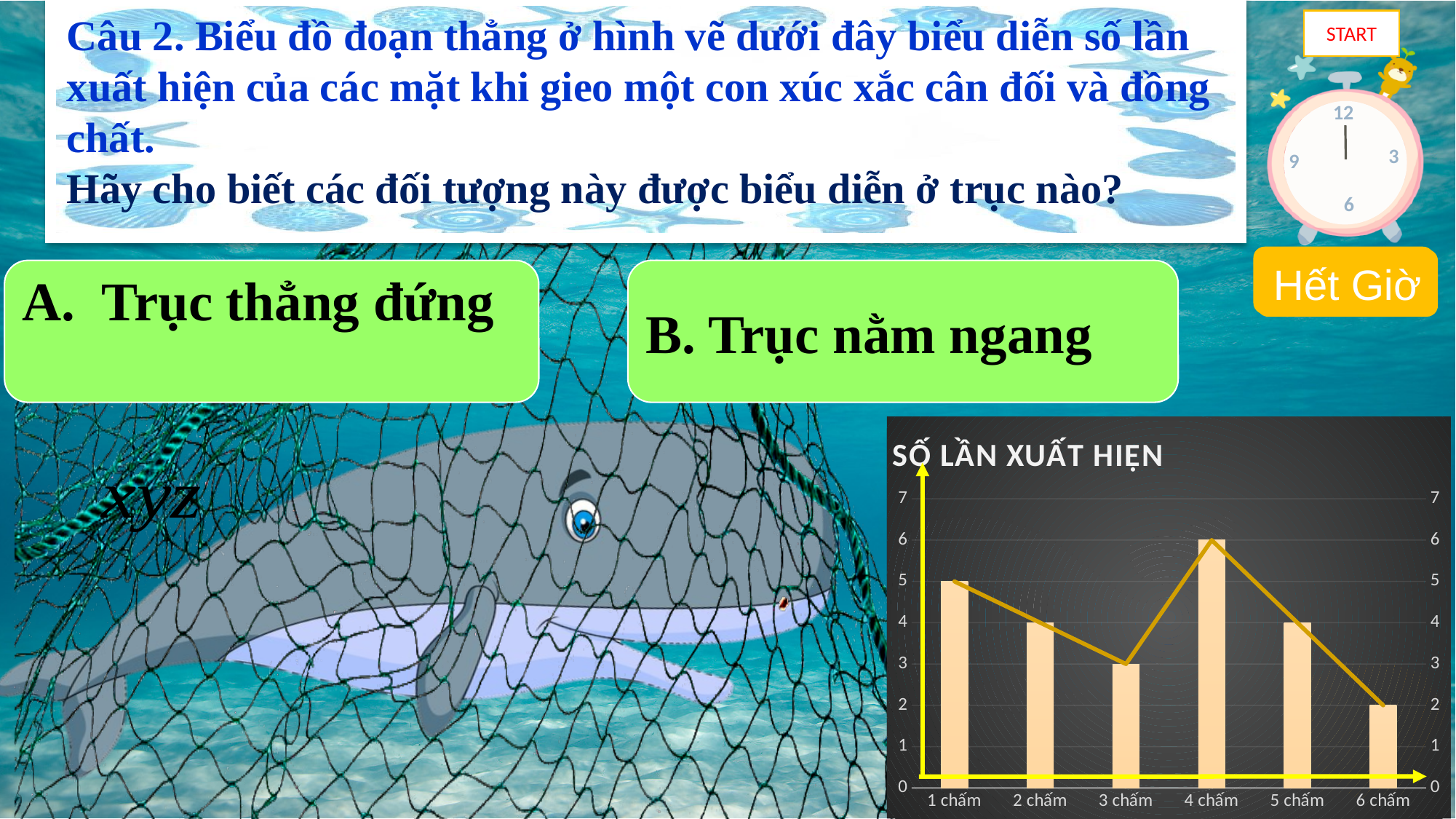
What is the value for 3 chấm? 3 Which is larger, the value for 1 chấm or the value for 2 chấm? 1 chấm What is the title of the chart? SỐ LẦN XUẤT HIỆN Which category has the lowest value? 6 chấm What is the difference between the values for 4 chấm and 6 chấm? 4 Do the values rise or fall from 4 chấm to 6 chấm? fall Which category has the highest value? 4 chấm How many categories are shown on the x axis? 6 What is the highest tick value shown on the vertical axis? 7 What is the value for 4 chấm? 6 What is the value for 1 chấm? 5 What is the value for 6 chấm? 2